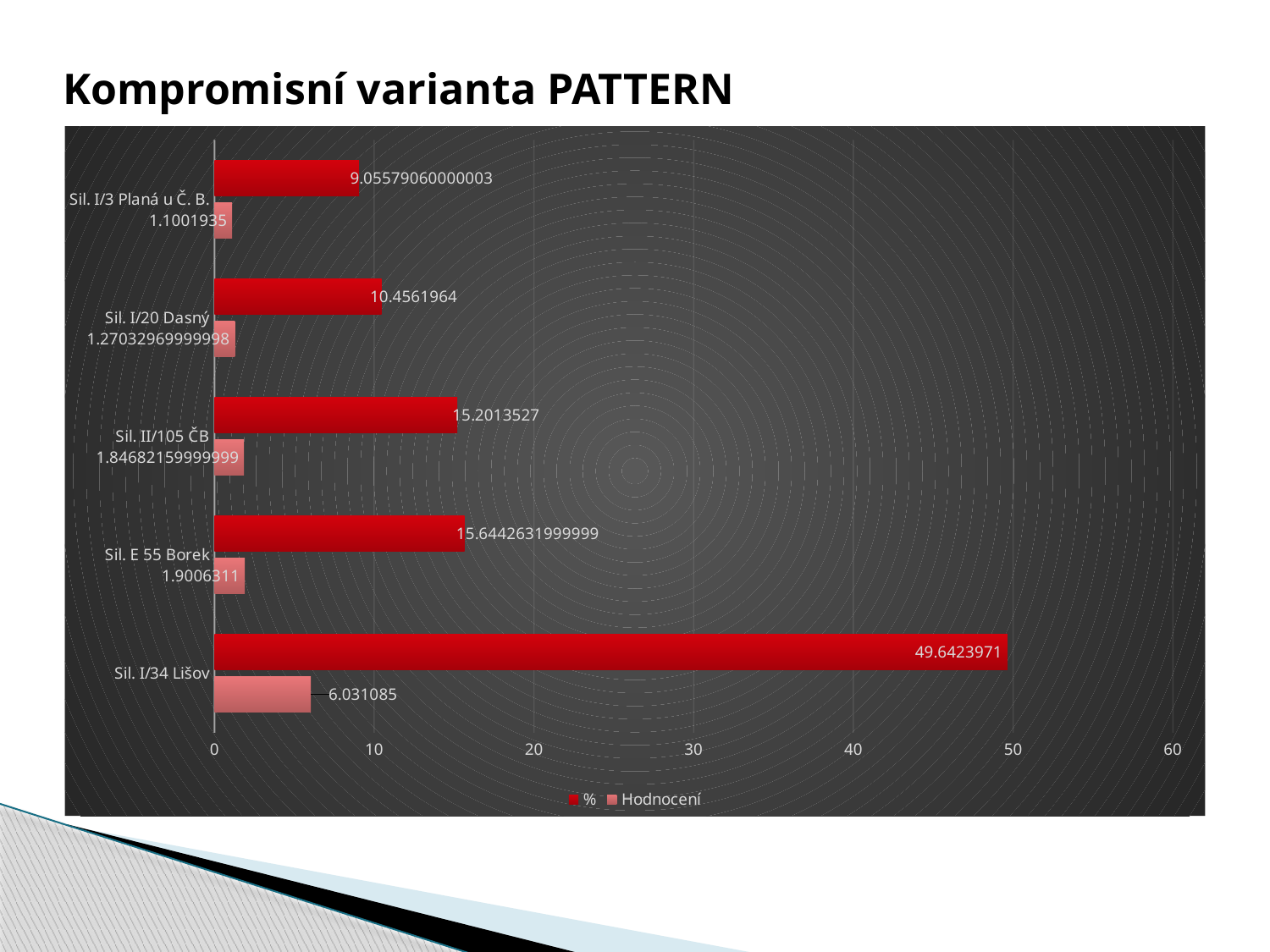
How many series does the legend list? 2 What type of chart is shown on the slide? Bar chart Is the % value for Sil. I/34 Lišov greater or less than 40? greater Which has a larger % value, Sil. I/20 Dasný or Sil. II/105 ČB? Sil. II/105 ČB What is the Hodnocení value for Sil. I/34 Lišov? 6.031085 What is the Hodnocení value for Sil. E 55 Borek? 1.9006311 How many categories are shown on the chart? 5 What is the % value for Sil. I/20 Dasný? 10.4561964 Which category has the lowest Hodnocení value? Sil. I/3 Planá u Č. B. What is the % value for Sil. II/105 ČB? 15.2013527 What is the % value for Sil. I/34 Lišov? 49.6423971 Which category has the highest % value? Sil. I/34 Lišov